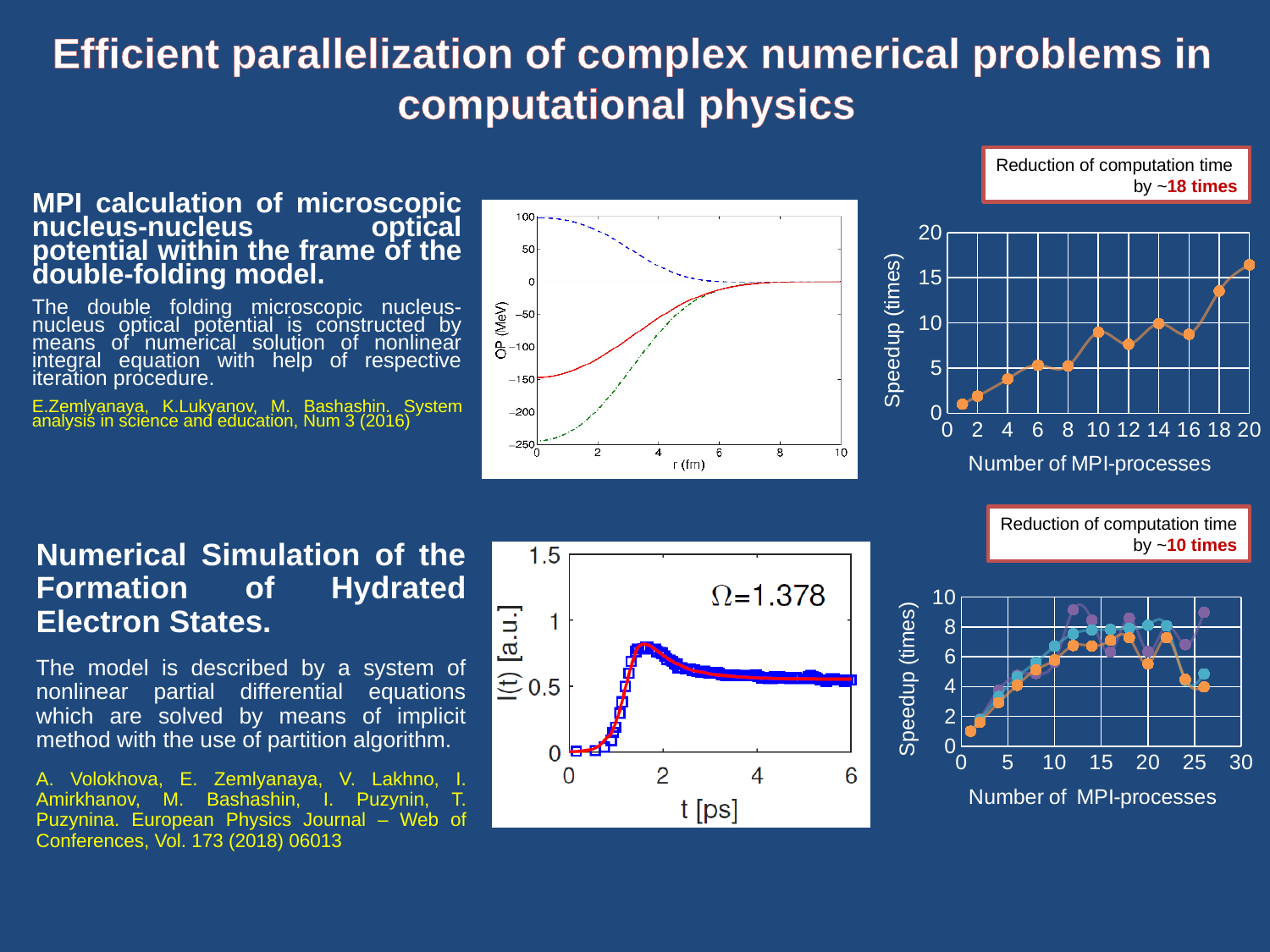
In the bottom-right speedup chart, what is the maximum value shown on the y axis? 10 In the bottom-right speedup chart, how many data series are plotted? 3 In the top-right speedup chart, is the speedup at 2 MPI-processes greater or less than 5? less In the top-right speedup chart, does the speedup generally rise or fall as the number of MPI-processes increases? rise In the top-right speedup chart, is the speedup at 20 MPI-processes greater or less than 15? greater In the top-right speedup chart, what is the label of the x axis? Number of MPI-processes In the top-right speedup chart, is the speedup at 18 MPI-processes greater or less than 10? greater In the top-right speedup chart, which has the larger speedup: 14 MPI-processes or 16 MPI-processes? 14 MPI-processes In the top-right speedup chart, at which number of MPI-processes is the speedup highest? 20 What kind of chart is the bottom-middle chart of I(t) [a.u.] versus t [ps]? line chart What kind of chart is the top-right chart of Speedup (times) versus Number of MPI-processes? line chart